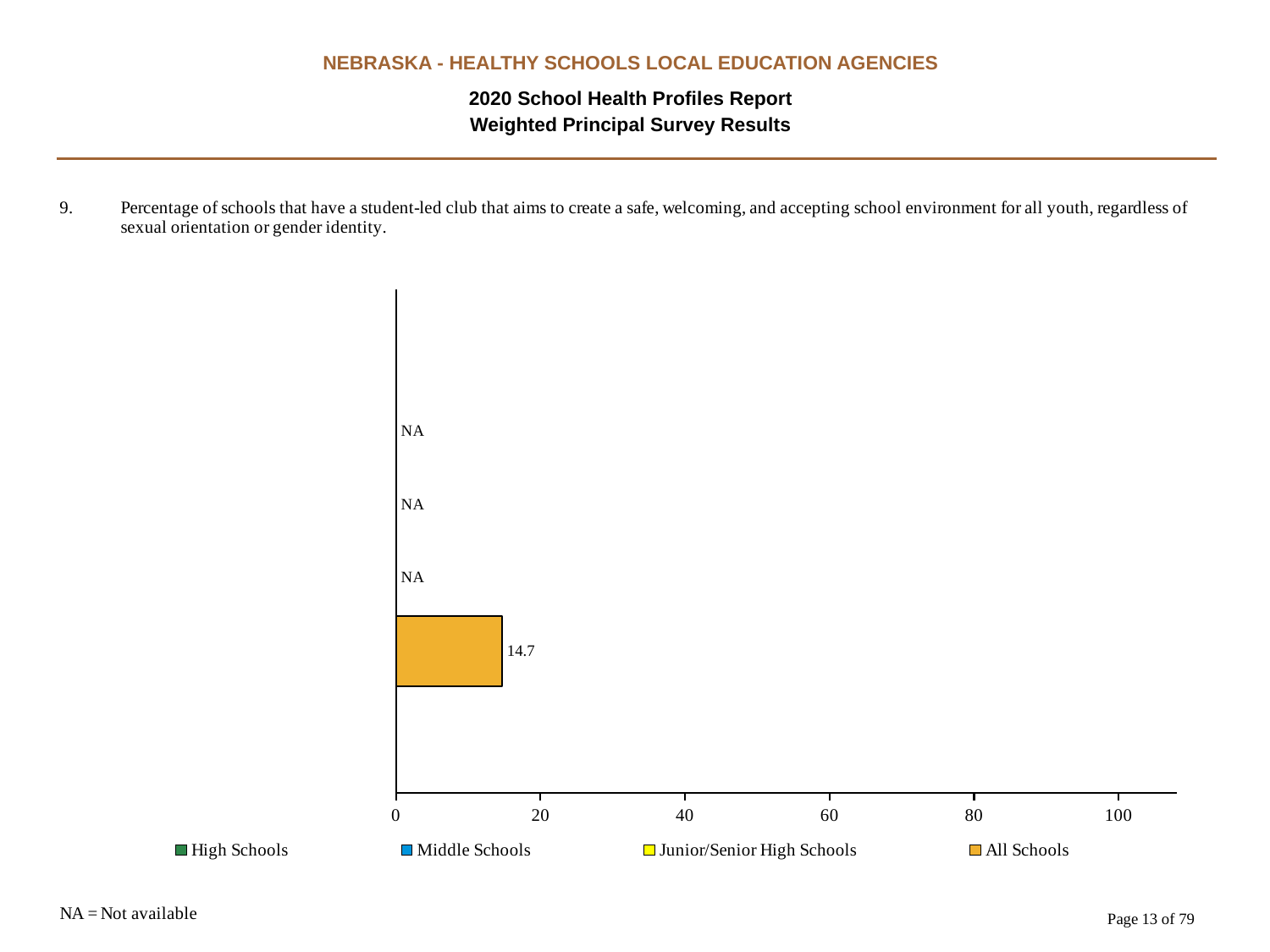
What is the highest value shown on the x axis? 100 Is the value for All Schools greater or less than 20? less Which series is the only one with a plotted bar? All Schools What is the value for All Schools? 14.7 What does NA stand for according to the note on the slide? Not available How many series does the legend list? 4 What kind of chart is shown on the slide? bar chart What is shown for Middle Schools in the chart? NA What is shown for High Schools in the chart? NA How many series have a plotted bar with a numeric value in the chart? 1 What is shown for Junior/Senior High Schools in the chart? NA Is the value for All Schools greater or less than 10? greater